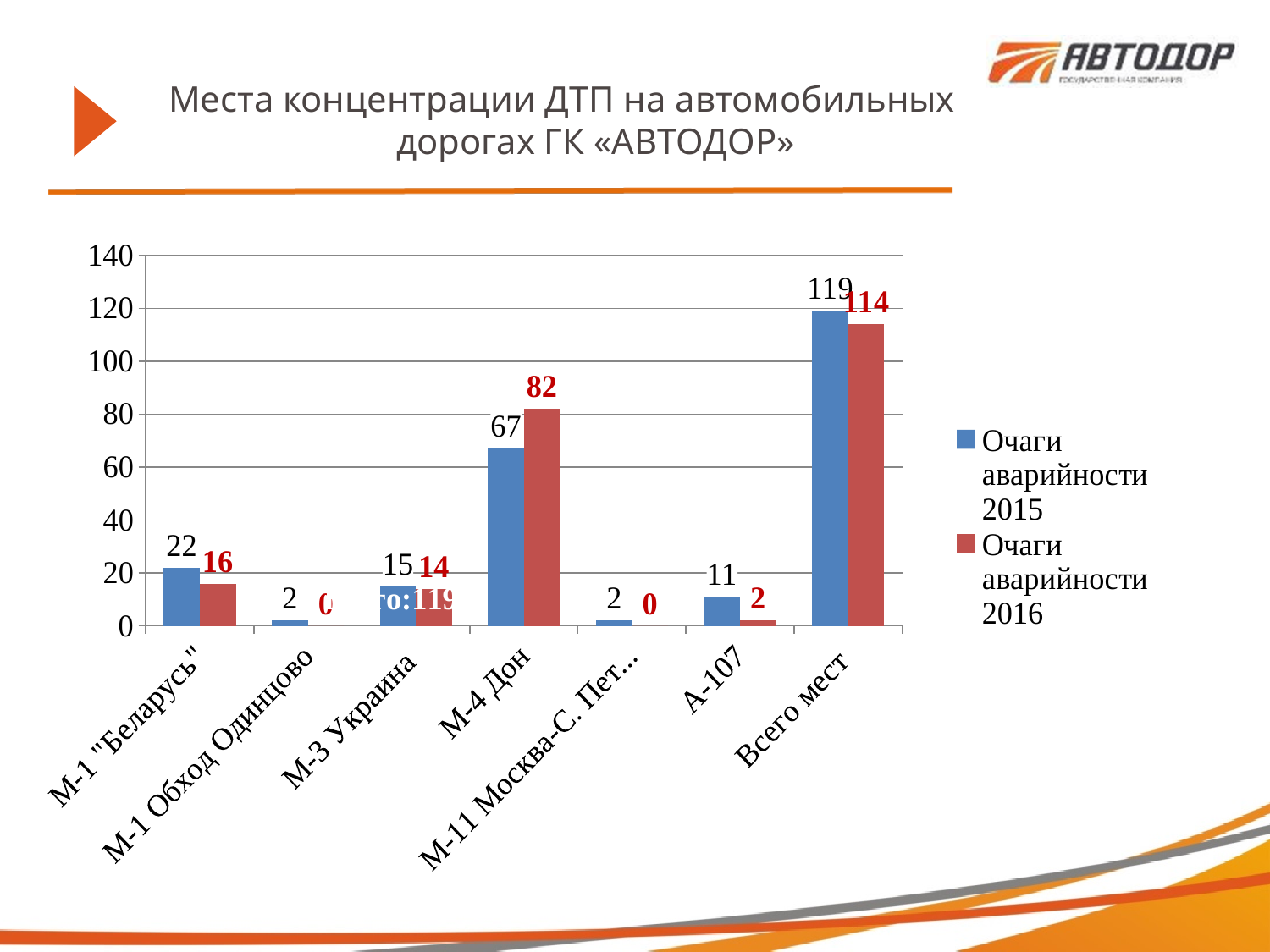
What is the value for Всего мест in the Очаги аварийности 2016 series? 114 Is the value for М-4 Дон in the Очаги аварийности 2015 series greater or less than 60? greater What kind of chart is shown on the slide? bar chart For М-1 "Беларусь", which is larger: the 2015 value or the 2016 value? 2015 What is the value for М-4 Дон in the Очаги аварийности 2016 series? 82 What is the difference between the 2015 and 2016 values for Всего мест? 5 Excluding Всего мест, which road has the highest value in the Очаги аварийности 2016 series? М-4 Дон How many series does the legend list? 2 Which category has the highest value in the Очаги аварийности 2015 series? Всего мест What is the difference between the 2016 and 2015 values for М-4 Дон? 15 What is the value for А-107 in the Очаги аварийности 2015 series? 11 What is the value for М-1 "Беларусь" in the Очаги аварийности 2015 series? 22